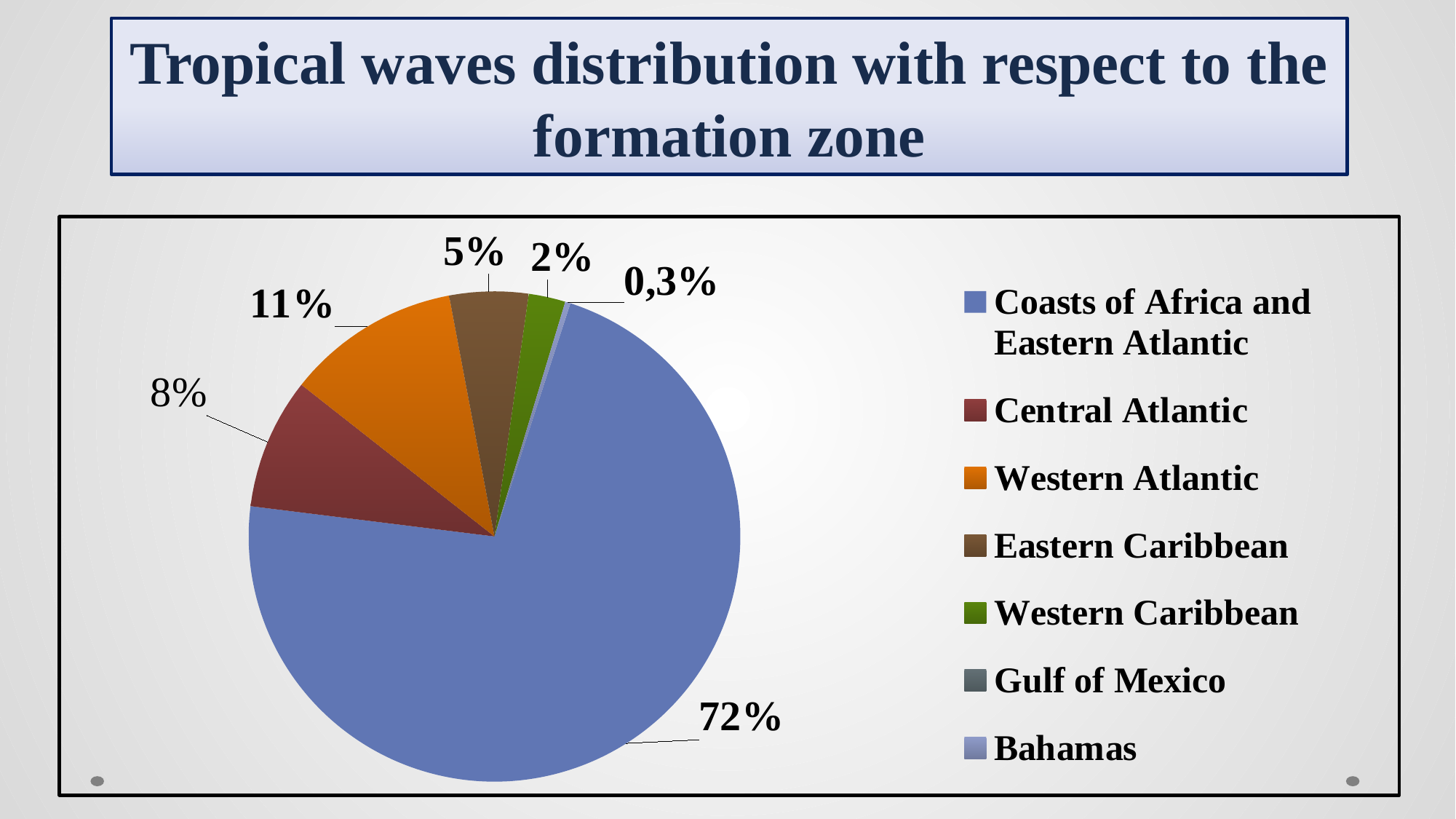
How many percentage points larger is the Coasts of Africa and Eastern Atlantic share than the Western Atlantic share? 61 What is the title of the slide containing the pie chart? Tropical waves distribution with respect to the formation zone What share of tropical waves formed in the Central Atlantic? 8% How many percentage points larger is the Central Atlantic share than the Eastern Caribbean share? 3 What share of tropical waves formed in the Eastern Caribbean? 5% What share of tropical waves formed in the Coasts of Africa and Eastern Atlantic zone? 72% Which has a larger share, Western Atlantic or Central Atlantic? Western Atlantic What kind of chart is shown on the slide? pie chart How many formation zones does the legend list? 7 Which formation zone has the largest share of the pie? Coasts of Africa and Eastern Atlantic